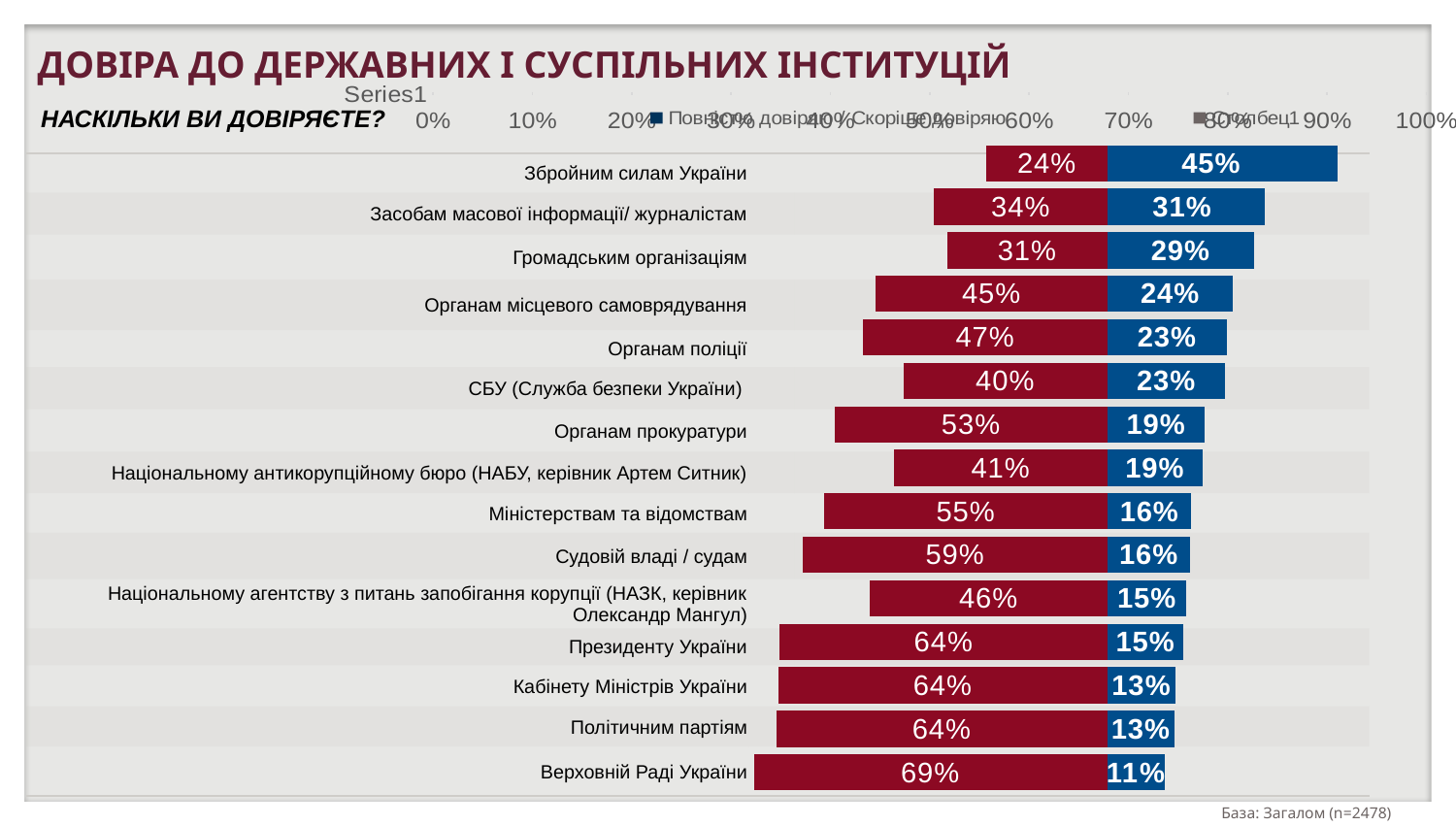
What is the title of the slide containing the chart? ДОВІРА ДО ДЕРЖАВНИХ І СУСПІЛЬНИХ ІНСТИТУЦІЙ What type of chart is shown on the slide? bar chart How many institutions (categories) are listed in the chart? 15 Which institution has the lowest blue-bar value? Верховній Раді України What is the difference between the red-bar values for Верховній Раді України and Президенту України? 5% What is the red-bar value for Верховній Раді України? 69% Which has a larger blue-bar value: Засобам масової інформації/ журналістам or Громадським організаціям? Засобам масової інформації/ журналістам What is the red-bar value for Органам прокуратури? 53% What is the blue-bar value for Збройним силам України? 45% What is the combined total of the red and blue bars for Збройним силам України? 69% Which institution has the highest blue-bar value? Збройним силам України Which institution has the lowest red-bar value? Збройним силам України